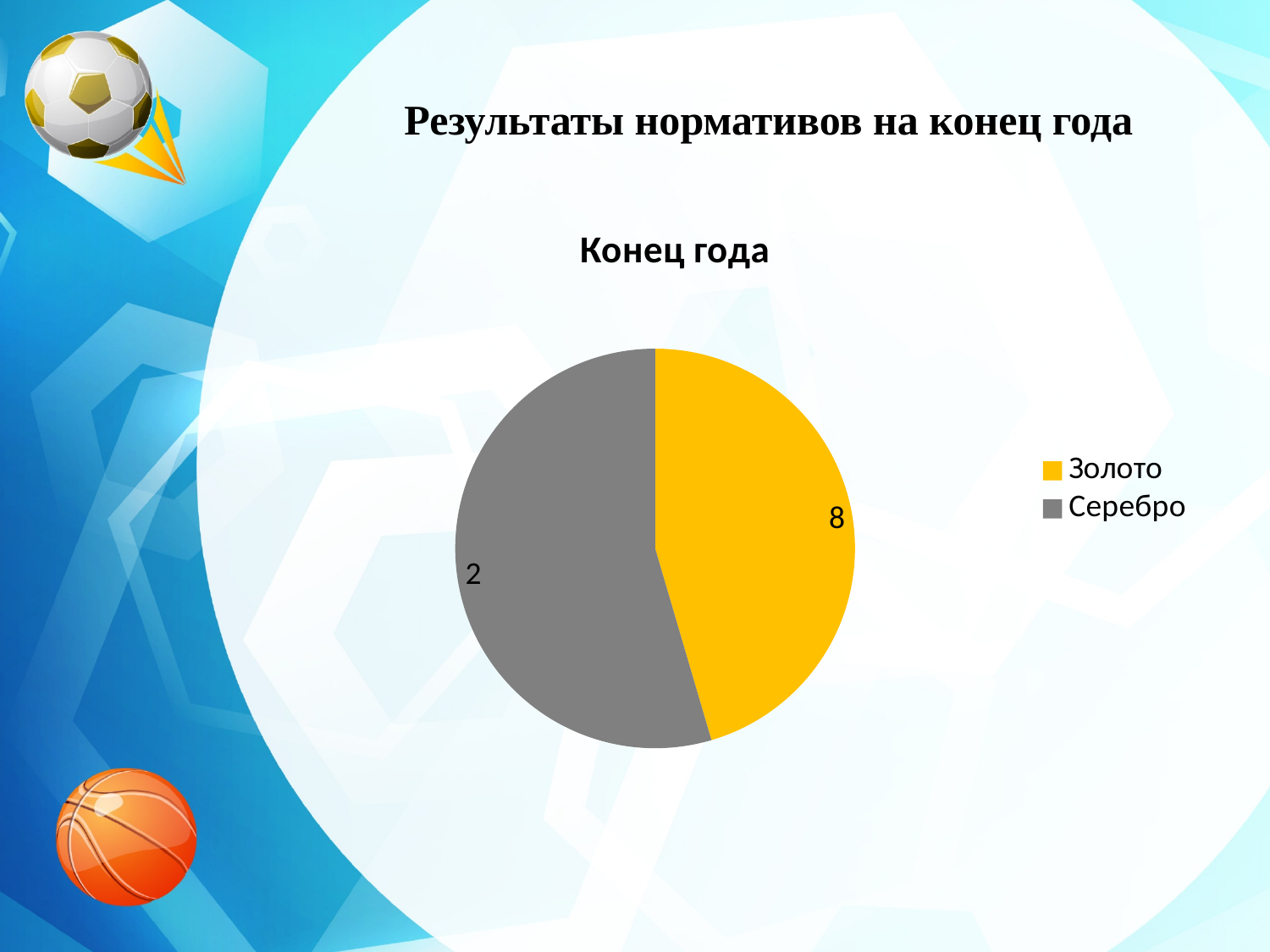
What is the difference between the values for Золото and Серебро? 6 What is the value for Золото? 8 How many categories does the pie chart have? 2 What colour is the Серебро slice? grey How many entries does the legend list? 2 Which category has the smallest slice? Золото What is the title of the chart? Конец года What is the total of the values shown in the pie chart? 10 What is the value for Серебро? 2 What type of chart is shown on the slide? pie chart Which category has the largest slice? Серебро